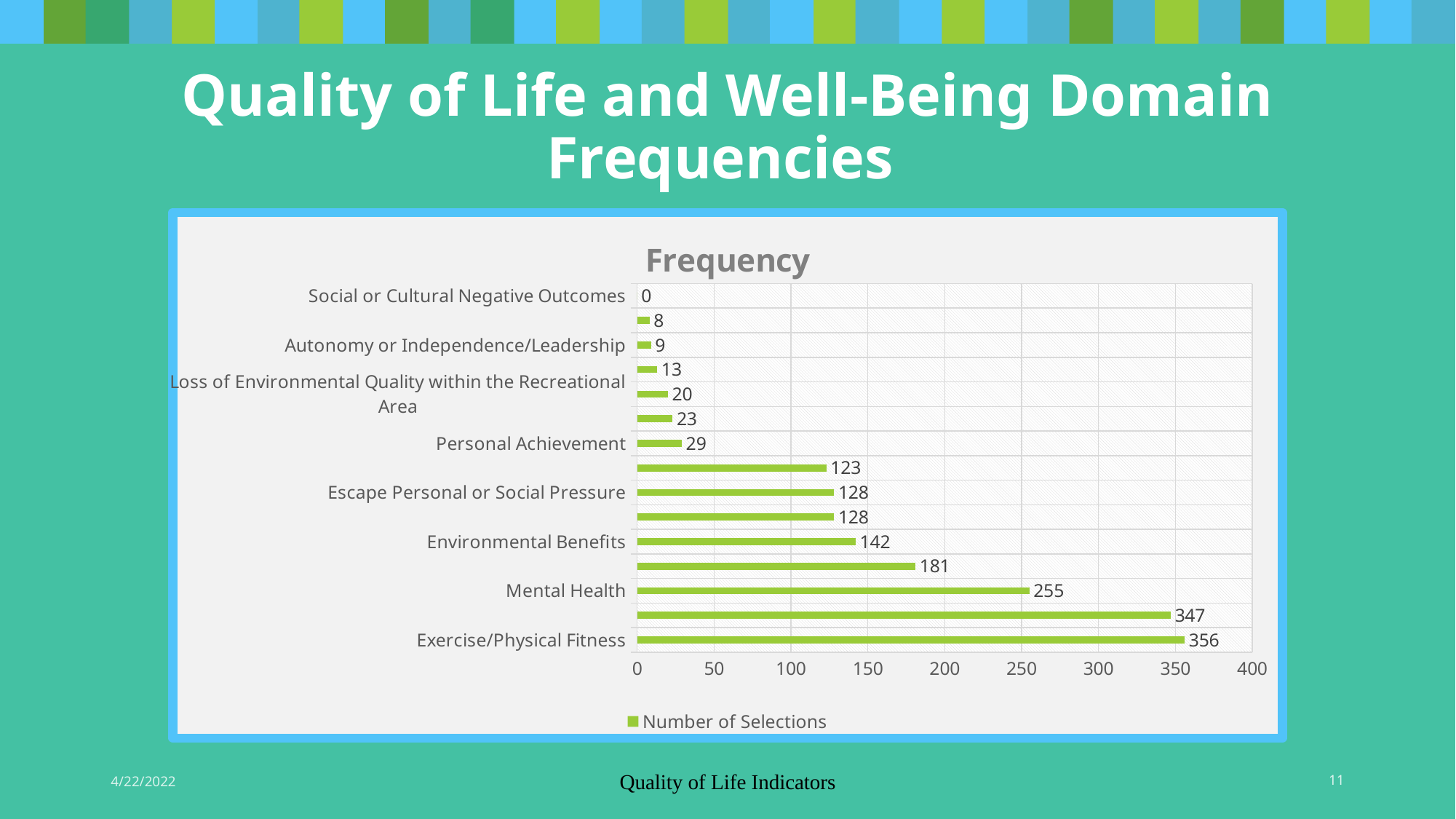
Which category has the highest value? Exercise/Physical Fitness What is the difference between the values for Exercise/Physical Fitness and Mental Health? 101 What is the value for Exercise/Physical Fitness? 356 What is the value for Personal Achievement? 29 Which category has the lowest value? Social or Cultural Negative Outcomes Which is larger, the value for Mental Health or the value for Environmental Benefits? Mental Health What is the value for Autonomy or Independence/Leadership? 9 What kind of chart is shown on the slide? bar chart How many series does the legend list? 1 What is the value for Environmental Benefits? 142 What is the value for Mental Health? 255 Is the value for Escape Personal or Social Pressure greater or less than 150? less